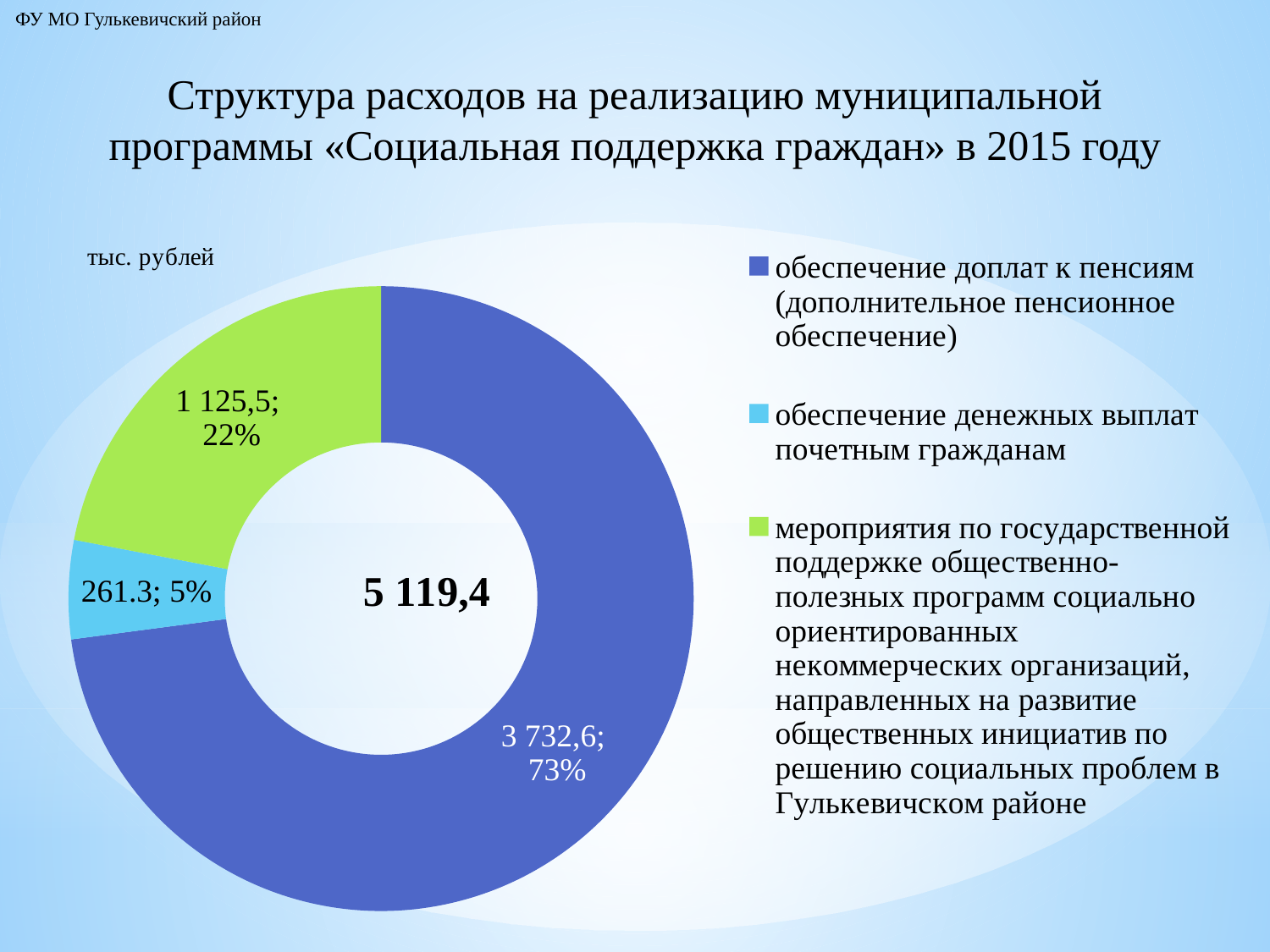
Which category has the smallest slice? обеспечение денежных выплат почетным гражданам What share of the chart does обеспечение доплат к пенсиям take? 73% How many categories does the legend list? 3 What is the value for обеспечение доплат к пенсиям (дополнительное пенсионное обеспечение)? 3 732,6 What kind of chart is shown on the slide? doughnut (pie) chart What is the total value shown in the centre of the chart? 5 119,4 What share of the chart do мероприятия по государственной поддержке общественно-полезных программ take? 22% What is the value for обеспечение денежных выплат почетным гражданам? 261.3 What unit is indicated above the chart? тыс. рублей Which category has the largest slice? обеспечение доплат к пенсиям (дополнительное пенсионное обеспечение) What share of the chart does обеспечение денежных выплат почетным гражданам take? 5% What is the value for мероприятия по государственной поддержке общественно-полезных программ социально ориентированных некоммерческих организаций? 1 125,5